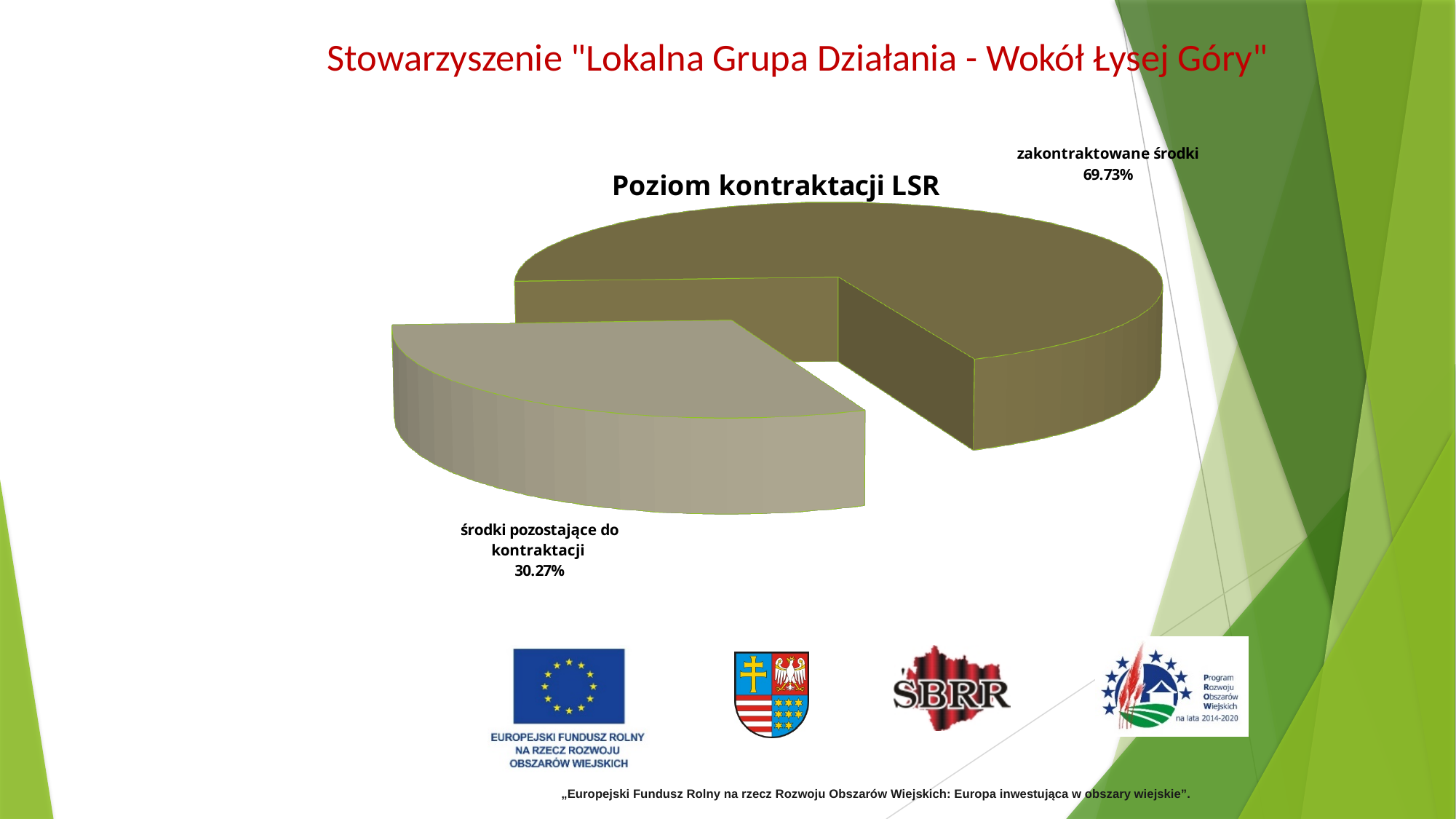
Which slice of the pie chart is the largest? zakontraktowane środki How many slices does the pie chart have? 2 What share of the pie is labelled "zakontraktowane środki"? 69.73% What kind of chart is shown on the slide? pie chart Which is larger: "zakontraktowane środki" or "środki pozostające do kontraktacji"? zakontraktowane środki Is the share for "środki pozostające do kontraktacji" greater or less than 50%? less Is the share for "zakontraktowane środki" greater or less than 50%? greater What is the title of the chart? Poziom kontraktacji LSR What is the difference in percentage points between "zakontraktowane środki" and "środki pozostające do kontraktacji"? 39.46 Which slice of the pie chart is the smallest? środki pozostające do kontraktacji Which slice of the pie chart is pulled out (exploded) from the rest of the pie? środki pozostające do kontraktacji What share of the pie is labelled "środki pozostające do kontraktacji"? 30.27%